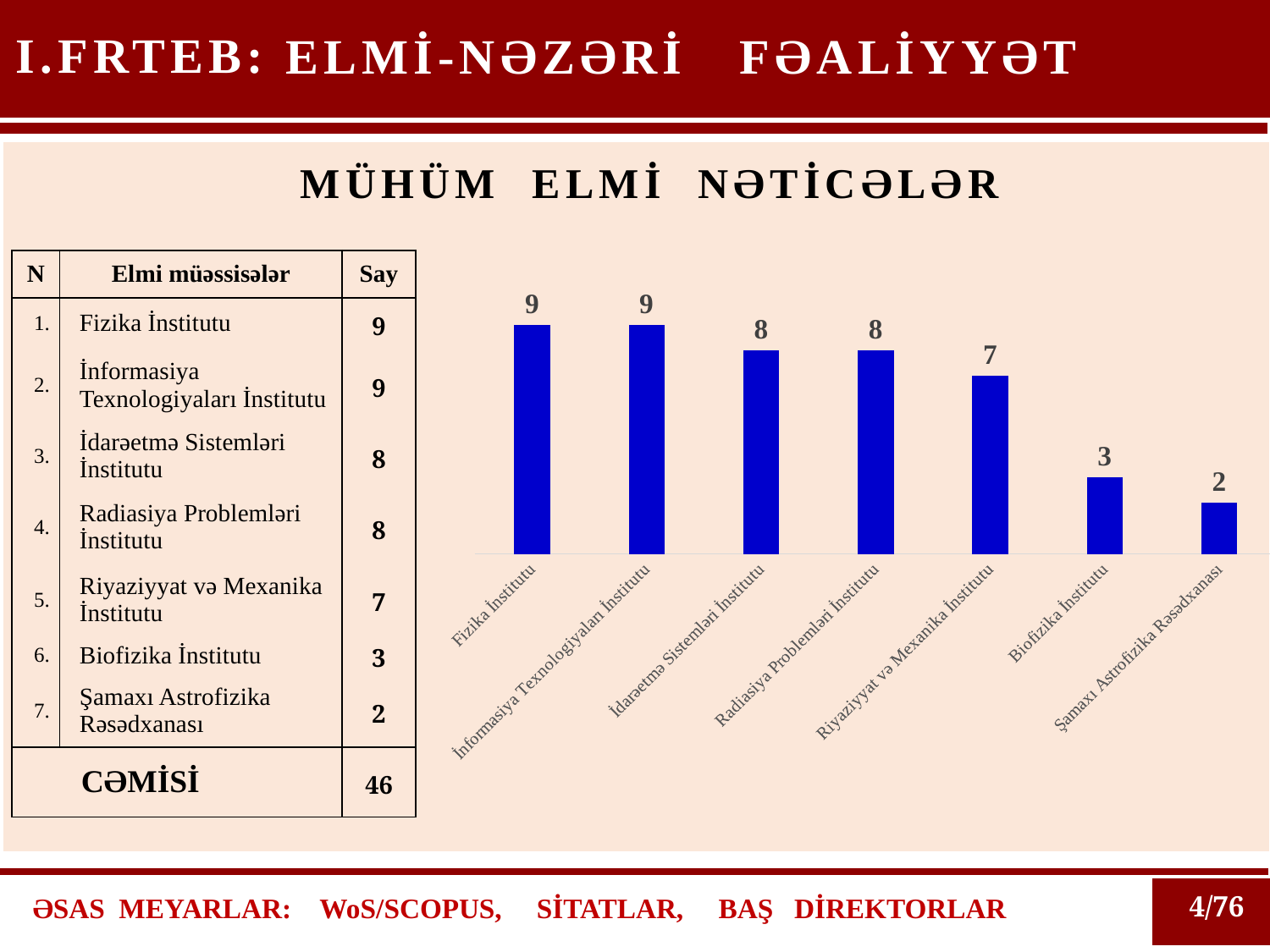
Which is larger: the value for İnformasiya Texnologiyaları İnstitutu or the value for Radiasiya Problemləri İnstitutu? İnformasiya Texnologiyaları İnstitutu What value is shown for Biofizika İnstitutu in the bar chart? 3 What value is shown for İdarəetmə Sistemləri İnstitutu in the bar chart? 8 What is the difference between the values for Fizika İnstitutu and Şamaxı Astrofizika Rəsədxanası? 7 Do the values in the bar chart rise or fall from left to right? Fall Which is larger: the value for Riyaziyyat və Mexanika İnstitutu or the value for Biofizika İnstitutu? Riyaziyyat və Mexanika İnstitutu What value is shown for Riyaziyyat və Mexanika İnstitutu in the bar chart? 7 What value is shown for Fizika İnstitutu in the bar chart? 9 What is the difference between the values for Radiasiya Problemləri İnstitutu and Biofizika İnstitutu? 5 What kind of chart is shown on the slide? Bar chart How many categories are shown in the bar chart? 7 Which category has the lowest value in the bar chart? Şamaxı Astrofizika Rəsədxanası